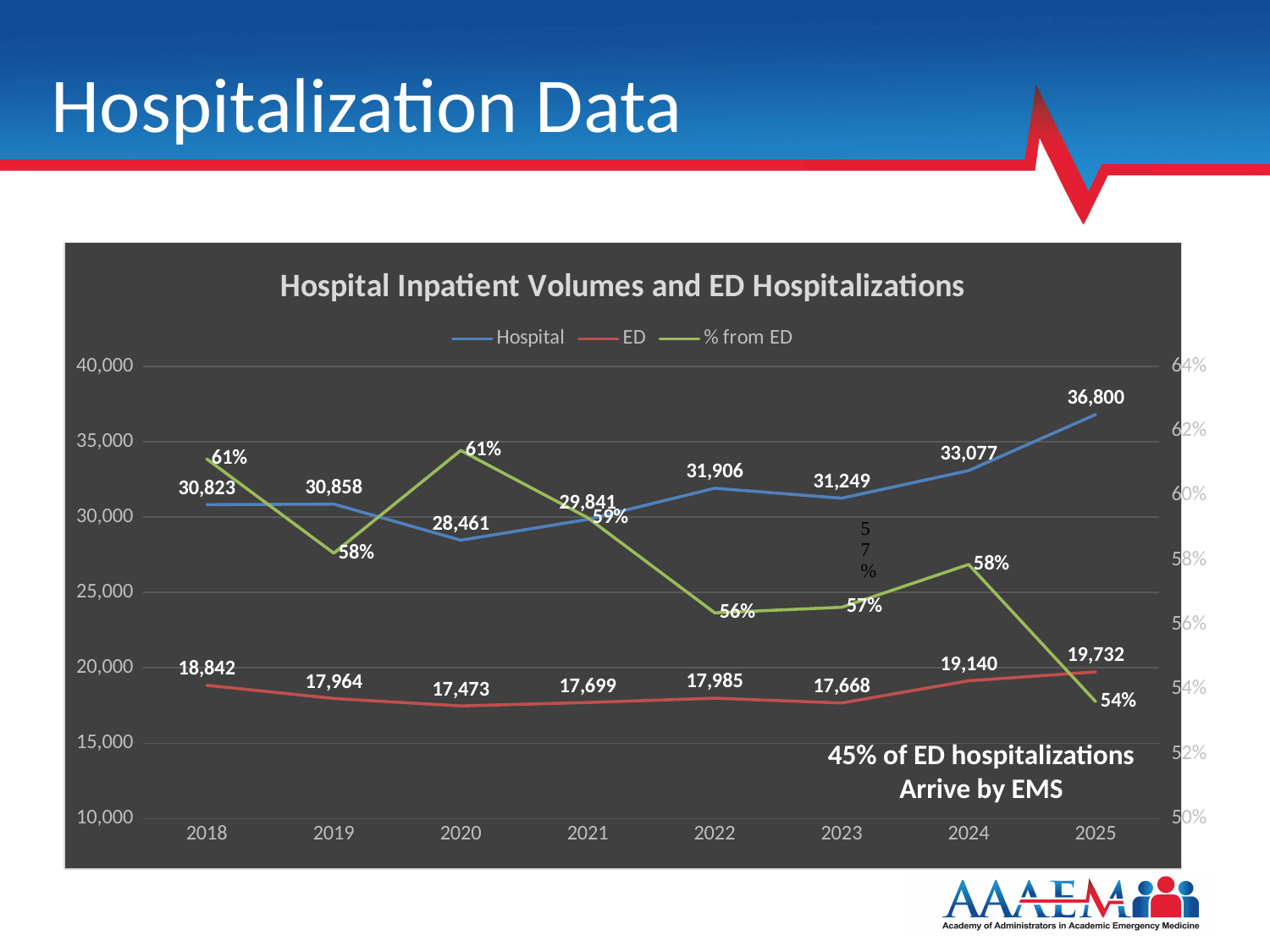
What type of chart is shown on the slide? line chart How many years are plotted on the x axis? 8 What is the title of the chart? Hospital Inpatient Volumes and ED Hospitalizations What is the difference between the Hospital value in 2025 and the Hospital value in 2024? 3,723 Does the Hospital series rise or fall from 2023 to 2025? rise Which is larger, the ED value for 2018 or the ED value for 2019? 2018 Which year has the lowest ED value? 2020 What is the % from ED value for 2022? 56% Which year has the highest Hospital value? 2025 How many series does the legend list? 3 What is the Hospital value for 2025? 36,800 What is the ED value for 2020? 17,473